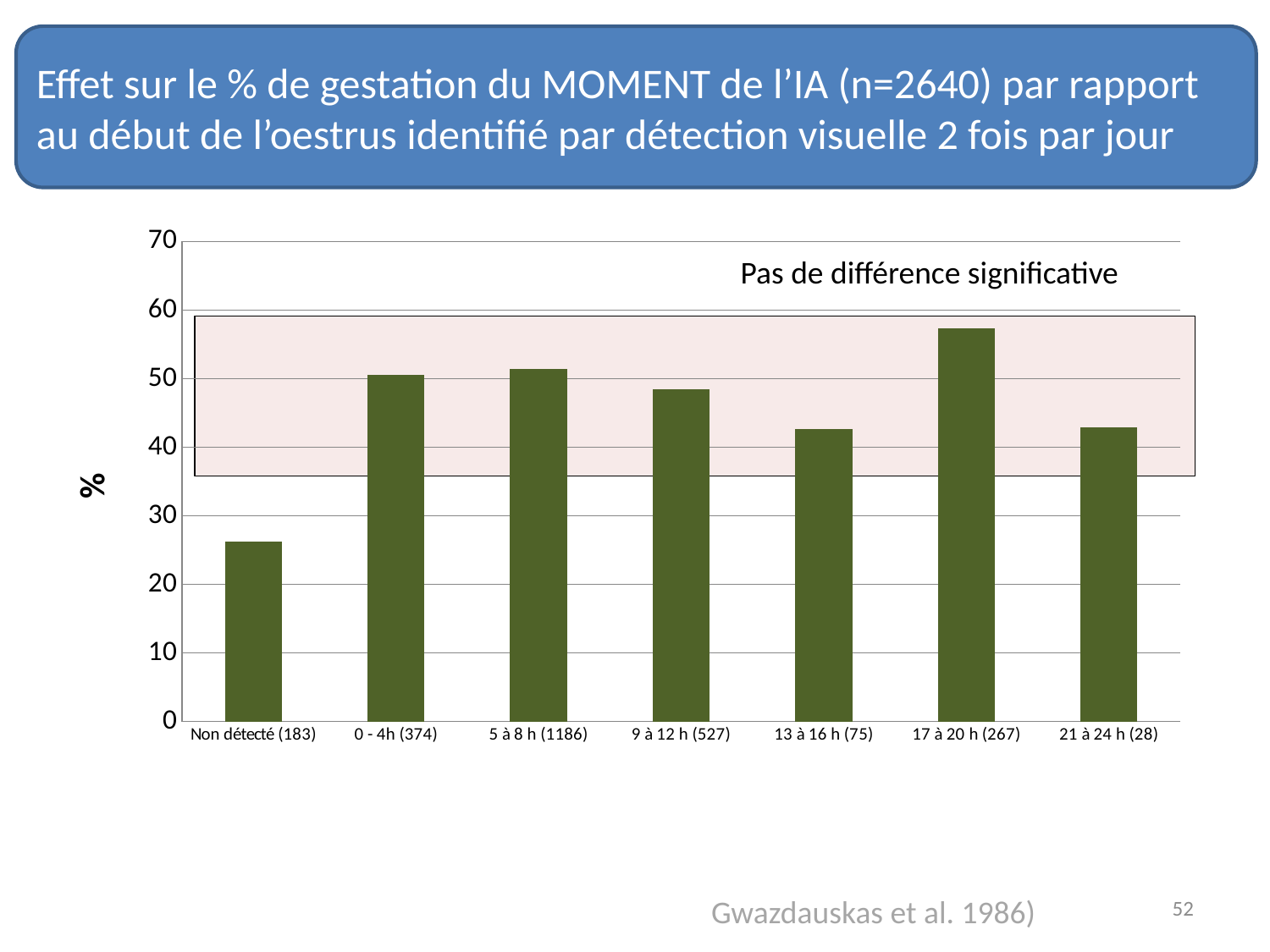
How many categories are shown on the x axis of the chart? 7 What text annotation appears inside the chart area above the bars? Pas de différence significative Is the value for 17 à 20 h (267) greater or less than 50? greater Is the value for 0 - 4h (374) greater or less than 40? greater Is the value for Non détecté (183) greater or less than 30? less Which is larger, the value for 17 à 20 h (267) or the value for 13 à 16 h (75)? 17 à 20 h (267) What is the label on the y axis of the chart? % Which category has the lowest gestation percentage? Non détecté (183) Which category has the highest gestation percentage? 17 à 20 h (267) Which is larger, the value for Non détecté (183) or the value for 0 - 4h (374)? 0 - 4h (374) What kind of chart is shown on the slide? bar chart